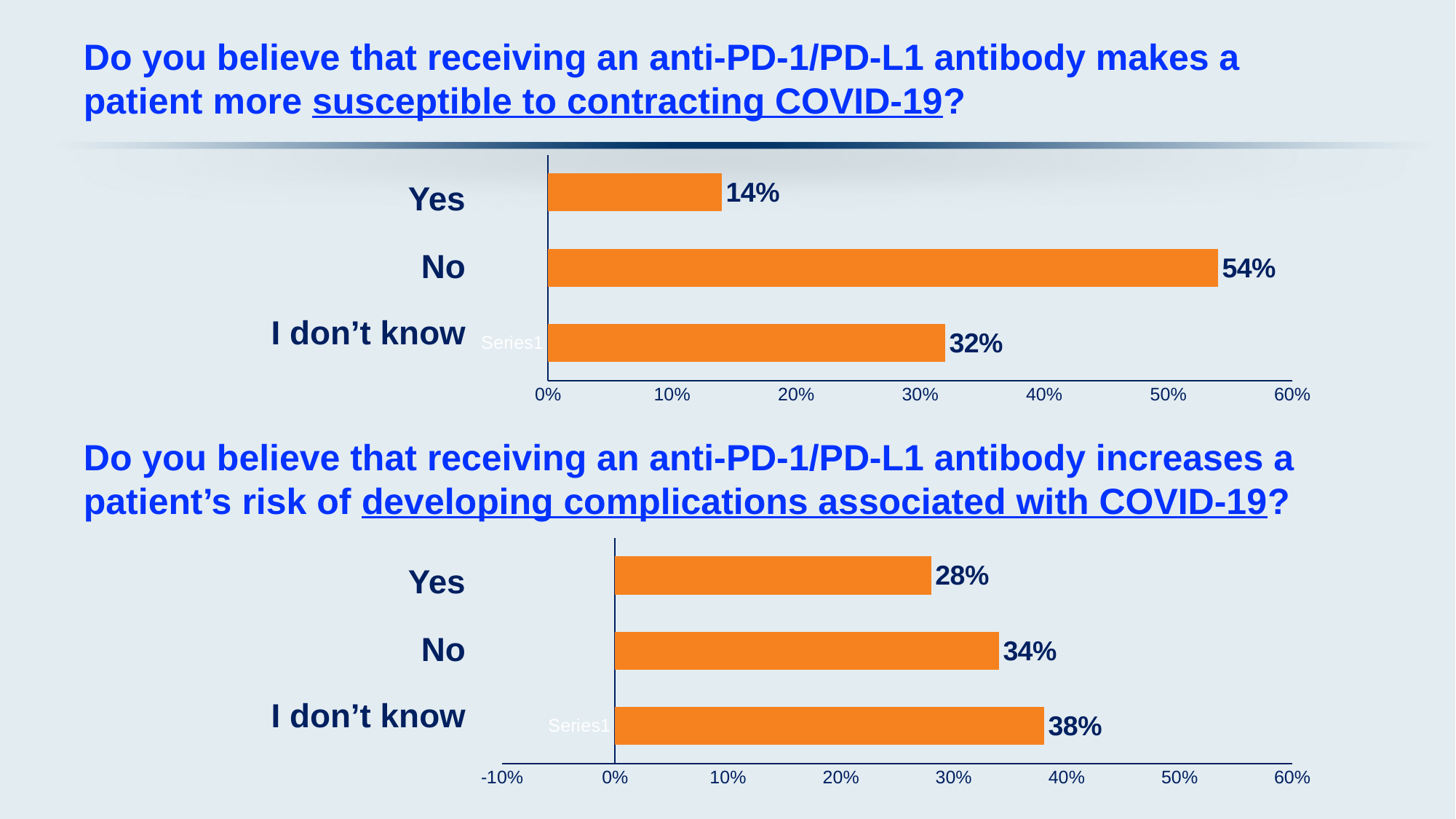
In the top chart (susceptible to contracting COVID-19), is the value for 'I don't know' greater or less than 30%? greater In the bottom chart (developing complications associated with COVID-19), what is the difference between the 'I don't know' and 'Yes' percentages? 10% In the top chart (susceptible to contracting COVID-19), what is the difference between the 'No' and 'I don't know' percentages? 22% In the top chart (susceptible to contracting COVID-19), what percentage answered 'No'? 54% In the top chart (susceptible to contracting COVID-19), what percentage answered 'Yes'? 14% In the bottom chart (developing complications associated with COVID-19), which is larger: the 'No' percentage or the 'Yes' percentage? No What type of chart is used in the bottom chart (developing complications associated with COVID-19)? Bar chart In the top chart (susceptible to contracting COVID-19), which response has the highest percentage? No In the bottom chart (developing complications associated with COVID-19), what percentage answered 'Yes'? 28% In the bottom chart (developing complications associated with COVID-19), what percentage answered 'I don't know'? 38% In the bottom chart (developing complications associated with COVID-19), which response has the lowest percentage? Yes How many response categories does the top chart (susceptible to contracting COVID-19) show? 3